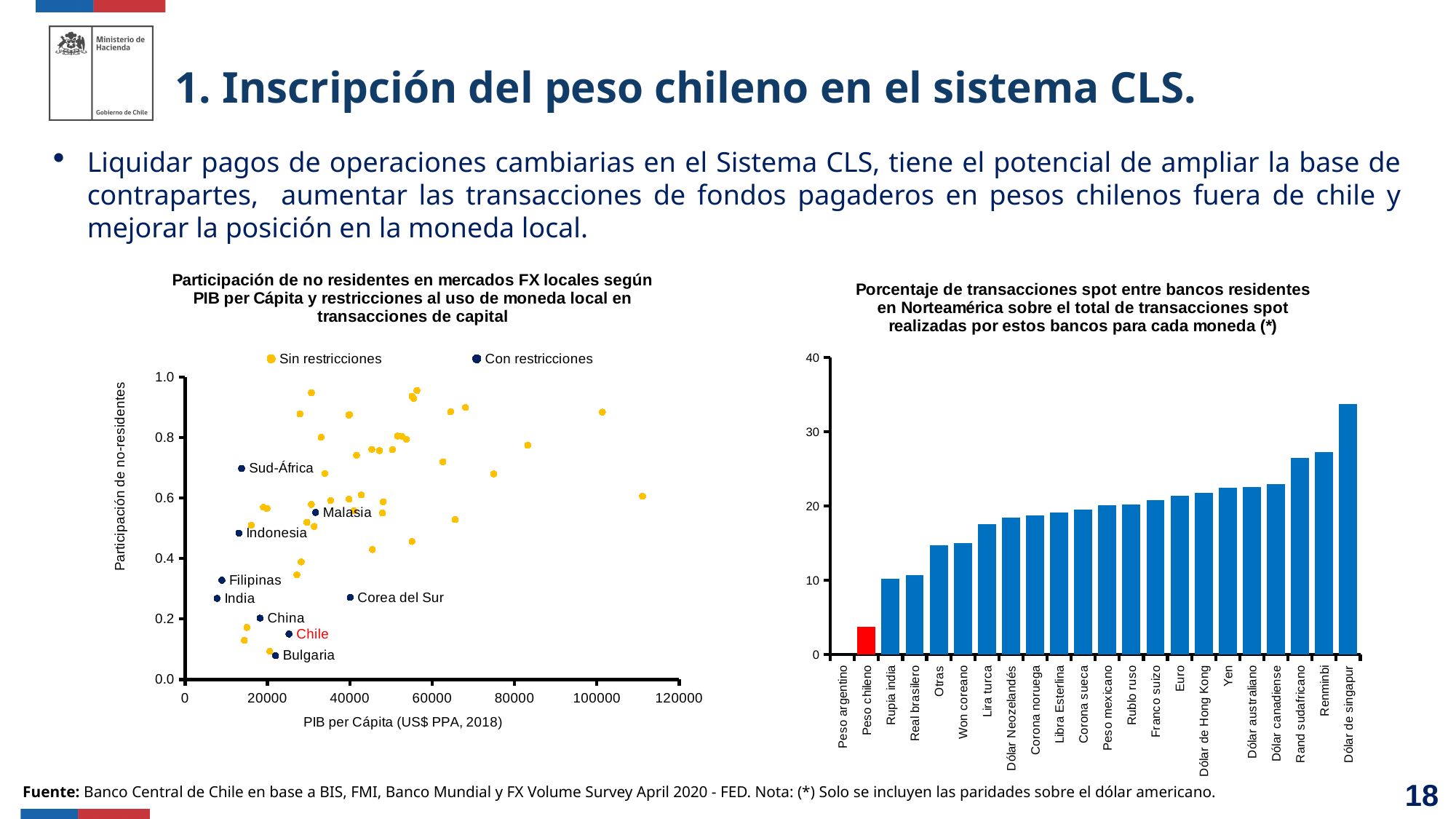
How many series does the legend of the left-hand scatter chart list? 2 In the right-hand bar chart, which currency has the lowest value? Peso argentino In the right-hand bar chart, which bar is coloured red? Peso chileno In the right-hand bar chart, is the value for Dólar de singapur greater or less than 30? greater In the left-hand scatter chart, is the participation value for Sud-África greater or less than 0.6? greater In the right-hand bar chart, which currency has the highest value? Dólar de singapur What kind of chart is the right-hand chart (Porcentaje de transacciones spot entre bancos residentes en Norteamérica)? bar chart In the right-hand bar chart, which is larger, Renminbi or Euro? Renminbi In the left-hand scatter chart, which has a higher participation of non-residents, Sud-África or Chile? Sud-África How many currencies are shown in the right-hand bar chart? 22 In the right-hand bar chart, is the value for Peso chileno greater or less than 10? less What kind of chart is the left-hand chart (Participación de no residentes en mercados FX locales)? scatter chart